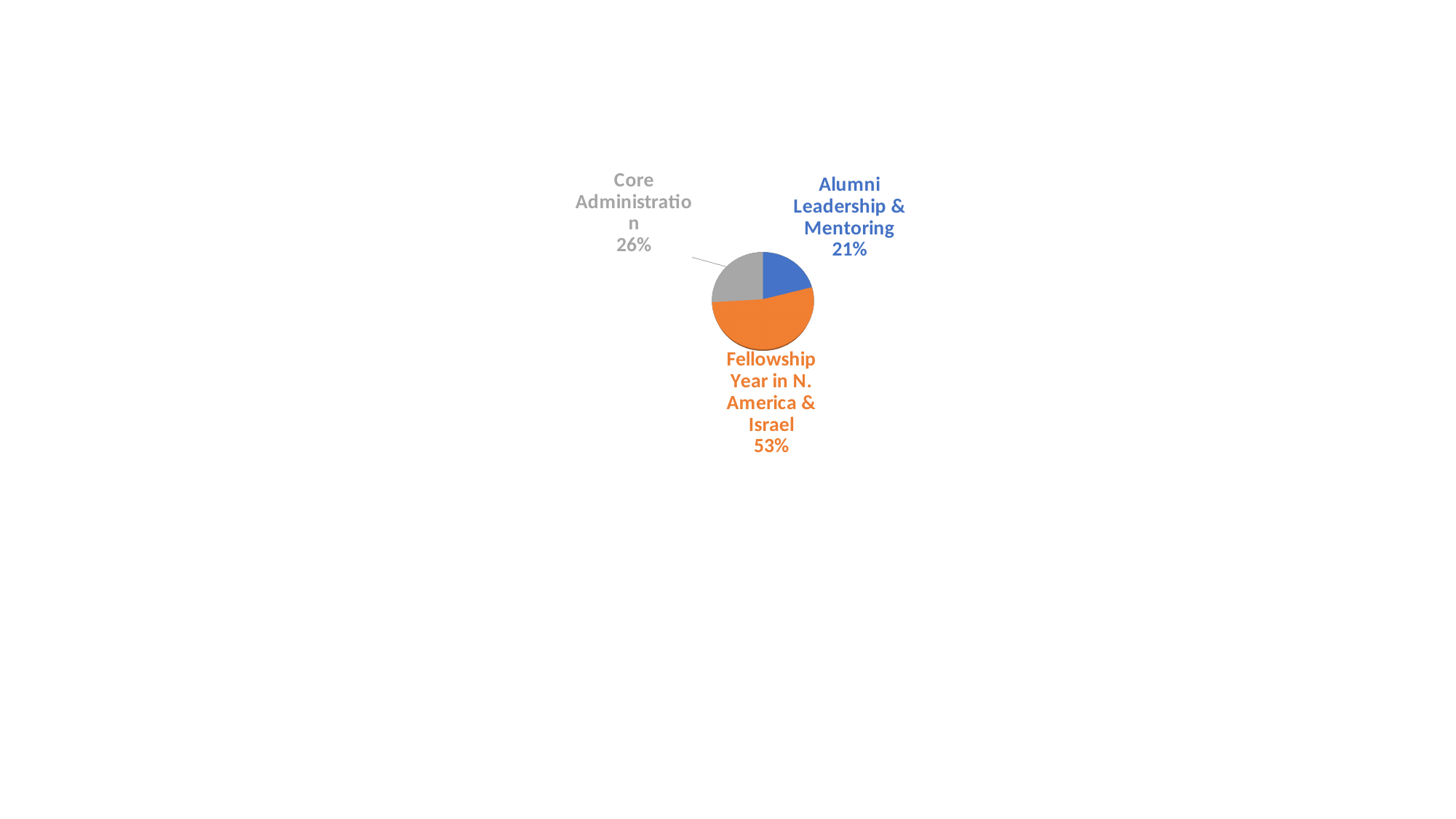
What colour is the Fellowship Year in N. America & Israel slice? orange What share of the pie does Alumni Leadership & Mentoring represent? 21% What is the difference in percentage points between Fellowship Year in N. America & Israel and Core Administration? 27 What is the difference in percentage points between Core Administration and Alumni Leadership & Mentoring? 5 What colour is the Core Administration slice? grey Which slice of the pie is the largest? Fellowship Year in N. America & Israel Which slice of the pie is the smallest? Alumni Leadership & Mentoring What share of the pie does Fellowship Year in N. America & Israel represent? 53% How many slices does the pie chart have? 3 Which is larger, the Core Administration slice or the Alumni Leadership & Mentoring slice? Core Administration What kind of chart is shown on the slide? pie chart What share of the pie does Core Administration represent? 26%